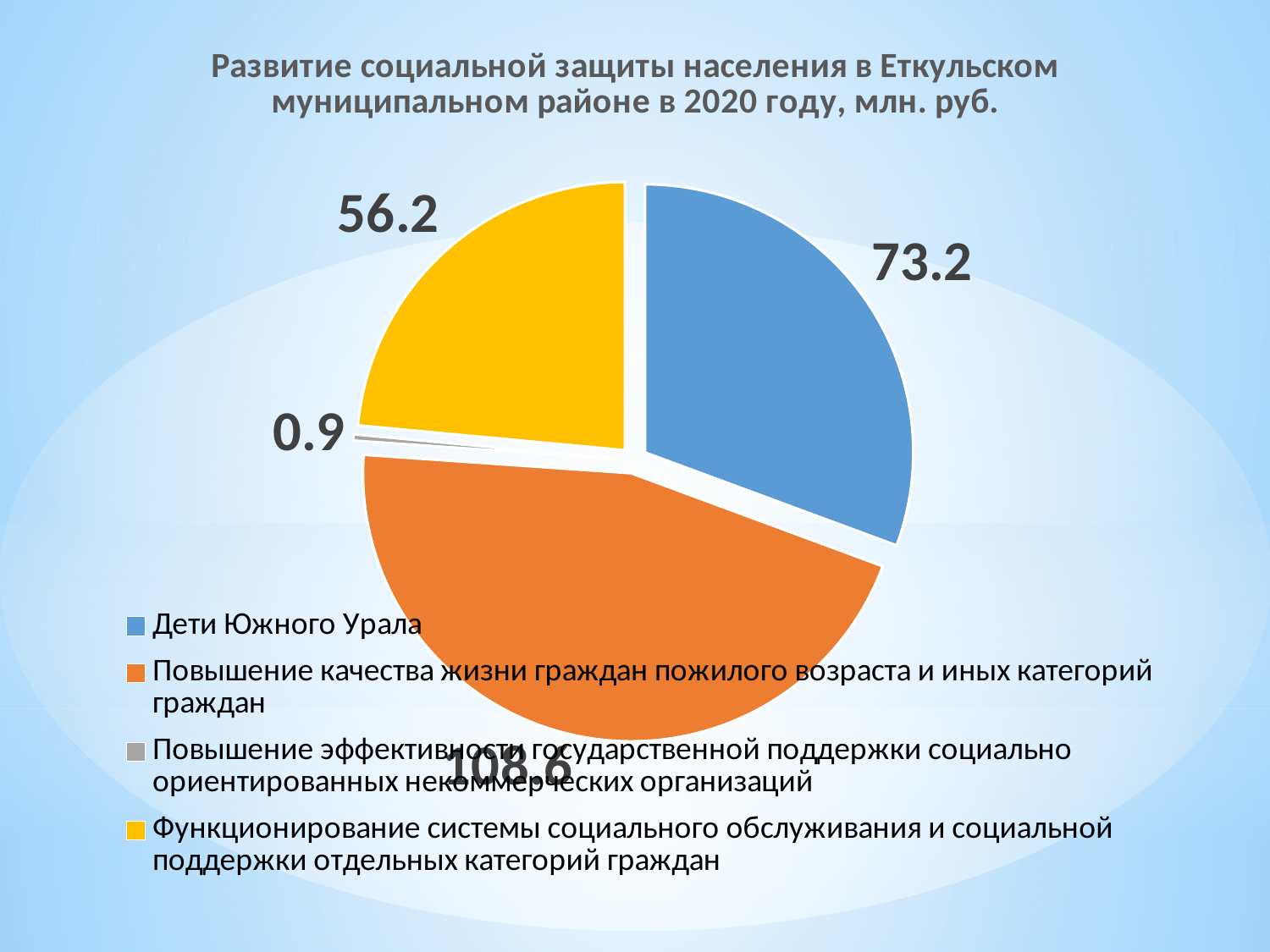
What kind of chart is shown on the slide? Pie chart What is the value for Дети Южного Урала? 73.2 What is the difference between the values for Повышение качества жизни граждан пожилого возраста и иных категорий граждан and Дети Южного Урала? 35.4 What is the difference between the values for Дети Южного Урала and Функционирование системы социального обслуживания и социальной поддержки отдельных категорий граждан? 17.0 Which category has the smallest slice of the pie? Повышение эффективности государственной поддержки социально ориентированных некоммерческих организаций What is the value for Повышение качества жизни граждан пожилого возраста и иных категорий граждан? 108.6 What colour is the slice for Дети Южного Урала? Blue What is the value for Повышение эффективности государственной поддержки социально ориентированных некоммерческих организаций? 0.9 What is the value for Функционирование системы социального обслуживания и социальной поддержки отдельных категорий граждан? 56.2 Which is larger: the value for Дети Южного Урала or the value for Функционирование системы социального обслуживания и социальной поддержки отдельных категорий граждан? Дети Южного Урала Which category has the largest slice of the pie? Повышение качества жизни граждан пожилого возраста и иных категорий граждан How many categories does the pie chart show? 4